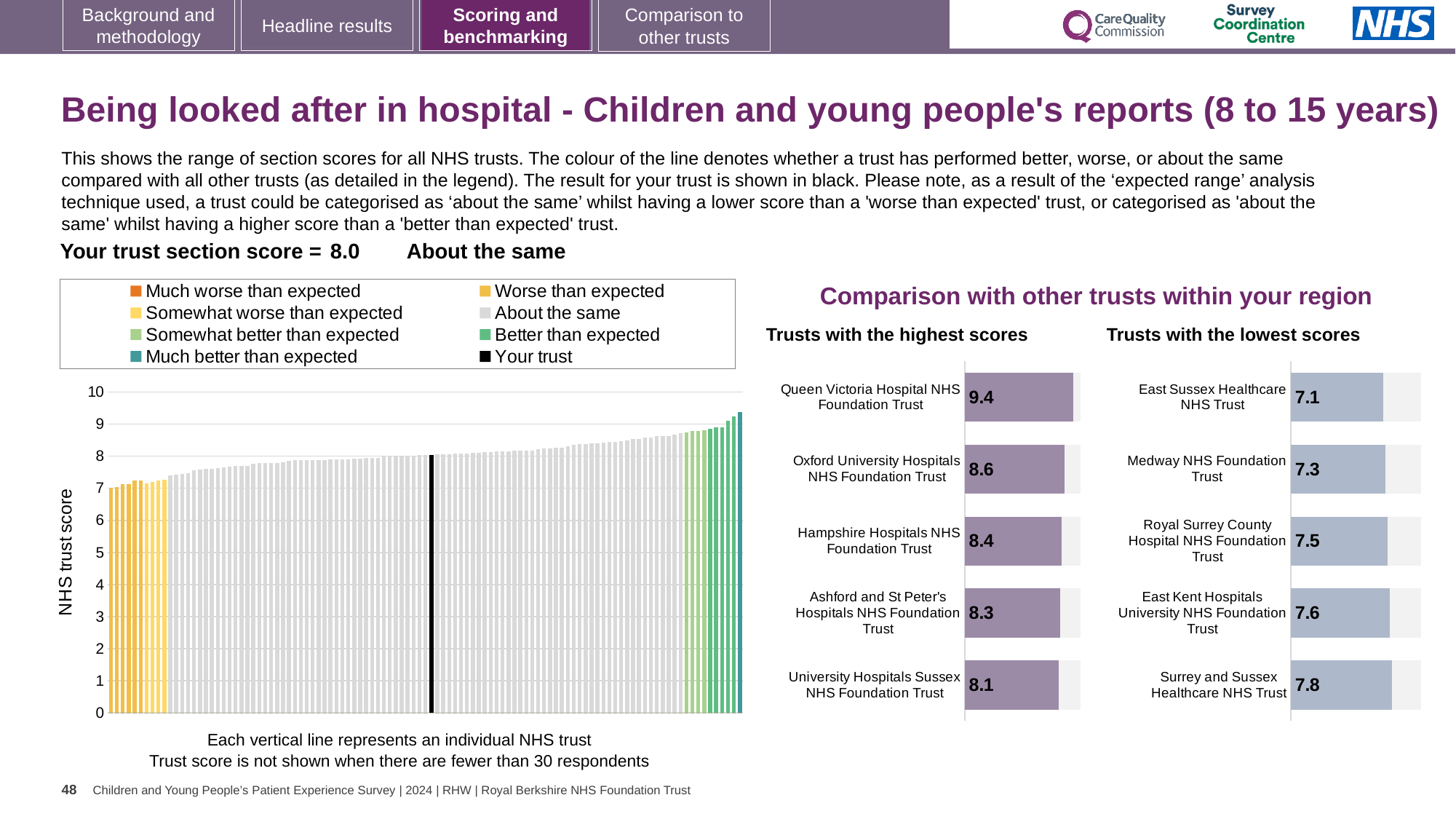
In the large chart on the left, is the value of the tallest bar greater or less than 9? greater In the 'Trusts with the lowest scores' chart, what is the difference between the scores of Surrey and Sussex Healthcare NHS Trust and East Sussex Healthcare NHS Trust? 0.7 How many entries does the legend above the large chart on the left list? 8 In the 'Trusts with the highest scores' chart, which trust has the lowest score shown? University Hospitals Sussex NHS Foundation Trust In the 'Trusts with the highest scores' chart, what is the difference between the scores of Queen Victoria Hospital NHS Foundation Trust and Oxford University Hospitals NHS Foundation Trust? 0.8 In the 'Trusts with the highest scores' chart, what is the score for Queen Victoria Hospital NHS Foundation Trust? 9.4 Which has a higher score: Hampshire Hospitals NHS Foundation Trust in the highest-scores chart or East Kent Hospitals University NHS Foundation Trust in the lowest-scores chart? Hampshire Hospitals NHS Foundation Trust How many trusts are shown in the 'Trusts with the lowest scores' chart? 5 In the 'Trusts with the lowest scores' chart, what is the score for Medway NHS Foundation Trust? 7.3 What kind of chart is the large chart on the left showing NHS trust scores? Bar chart In the large chart on the left, do the trust scores rise or fall from left to right? Rise In the 'Trusts with the lowest scores' chart, which trust has the highest score shown? Surrey and Sussex Healthcare NHS Trust